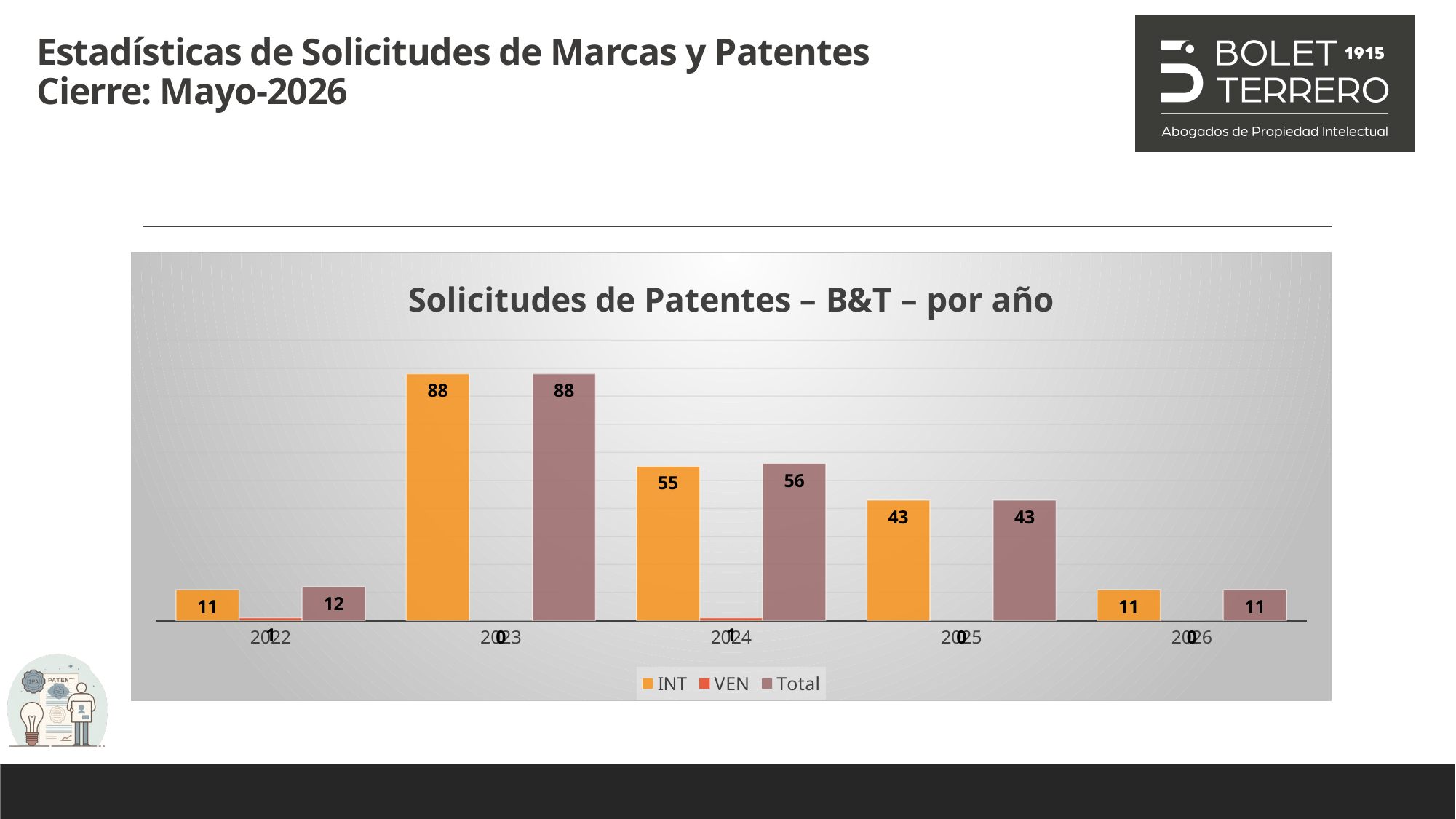
Which year has the highest INT value? 2023 Do the INT values rise or fall from 2023 to 2026? Fall What is the INT value for 2023 in the chart? 88 What is the difference between the INT values for 2023 and 2024? 33 What is the Total value for 2022? 12 What is the INT value for 2026? 11 What kind of chart is shown on the slide? Bar chart How many series does the legend list? 3 Which is larger, the Total for 2022 or the Total for 2026? Total for 2022 How many years are shown on the x axis? 5 What is the Total value for 2024? 56 Which year has the lowest Total value? 2026